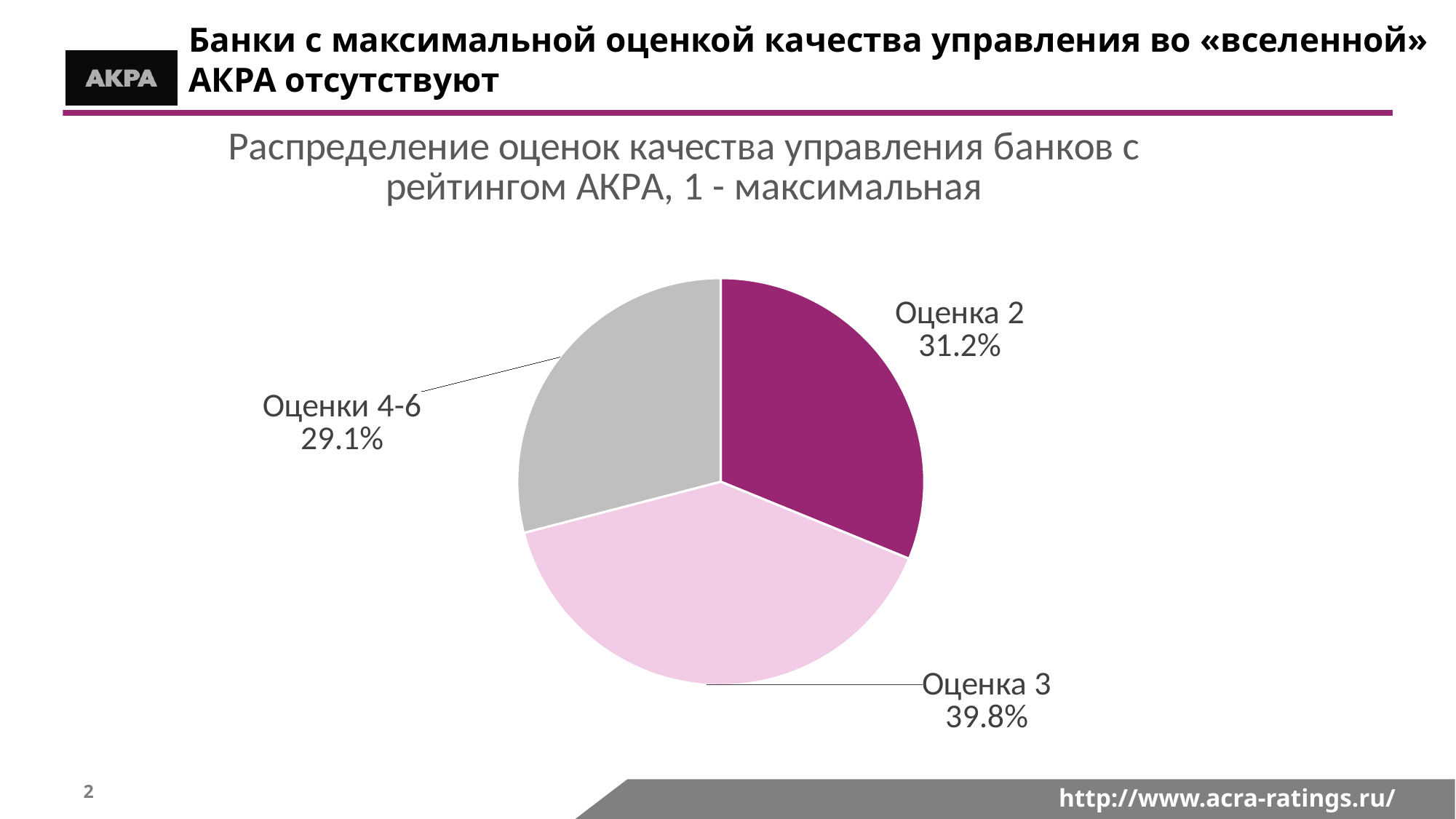
What colour is the slice for "Оценки 4-6"? Grey What share of the pie does "Оценка 2" represent? 31.2% What share of the pie does "Оценка 3" represent? 39.8% What type of chart is shown on the slide? Pie chart How many slices does the pie chart have? 3 What is the title of the chart? Распределение оценок качества управления банков с рейтингом АКРА, 1 - максимальная What is the difference in percentage points between "Оценка 3" and "Оценка 2"? 8.6 Which category has the smallest share of the pie? Оценки 4-6 What share of the pie does "Оценки 4-6" represent? 29.1% What is the difference in percentage points between "Оценка 2" and "Оценки 4-6"? 2.1 Which is larger: the share for "Оценка 2" or the share for "Оценки 4-6"? Оценка 2 Which category has the largest share of the pie? Оценка 3